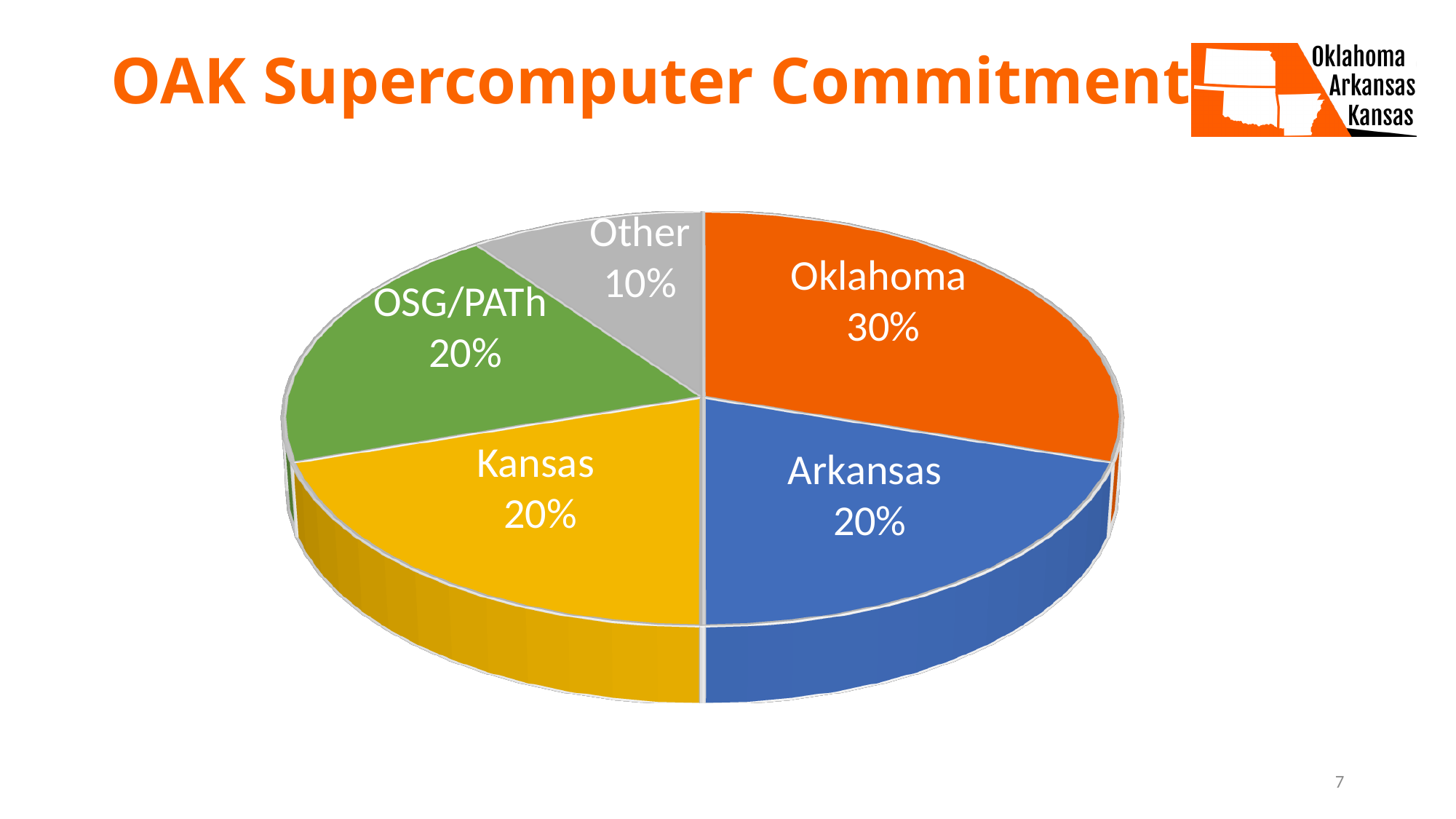
What share of the pie does Other have? 10% What share of the pie does OSG/PATh have? 20% What is the combined share of Kansas and Arkansas? 40% Which slice of the pie is the largest? Oklahoma Which slice of the pie is the smallest? Other How many slices does the pie chart have? 5 What kind of chart is shown on the slide? Pie chart What colour is the Kansas slice? Yellow What share of the pie does Oklahoma have? 30% Which is larger, the Oklahoma slice or the Arkansas slice? Oklahoma What is the title of the slide containing the chart? OAK Supercomputer Commitment What is the difference between the Oklahoma share and the Other share? 20%